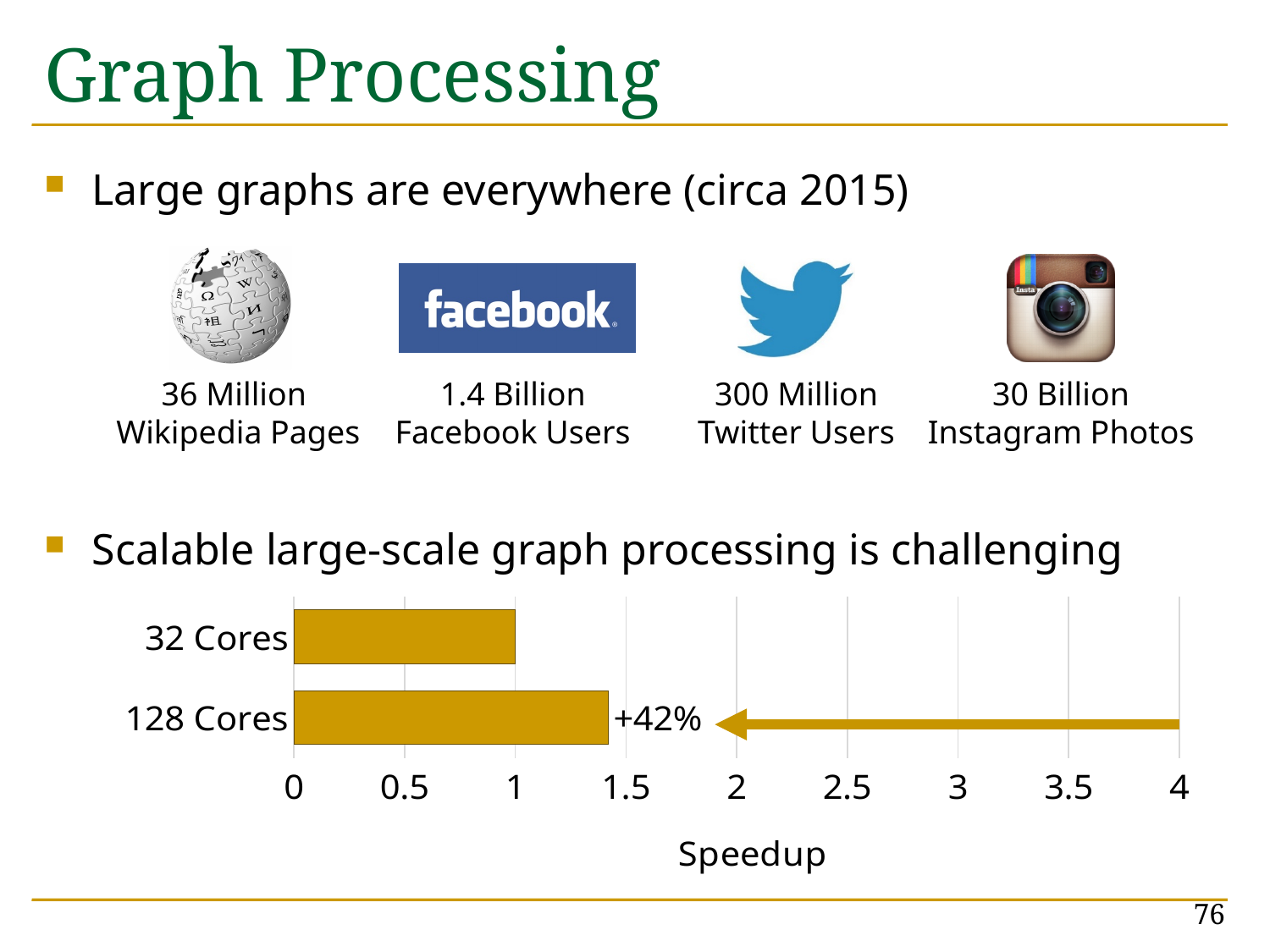
What is the maximum value shown on the Speedup axis? 4 What percentage annotation is shown next to the 128 Cores bar? +42% Is the speedup for 128 Cores greater or less than 1? greater What kind of chart is shown at the bottom of the slide? bar chart Is the speedup for 128 Cores greater or less than 1.5? less Which category has the higher speedup, 32 Cores or 128 Cores? 128 Cores Which category has the highest speedup? 128 Cores How many categories does the Speedup bar chart show? 2 Is the speedup for 128 Cores greater or less than 2? less What is the label of the x axis of the bar chart? Speedup What is the speedup value for 32 Cores? 1 Which category has the lowest speedup? 32 Cores